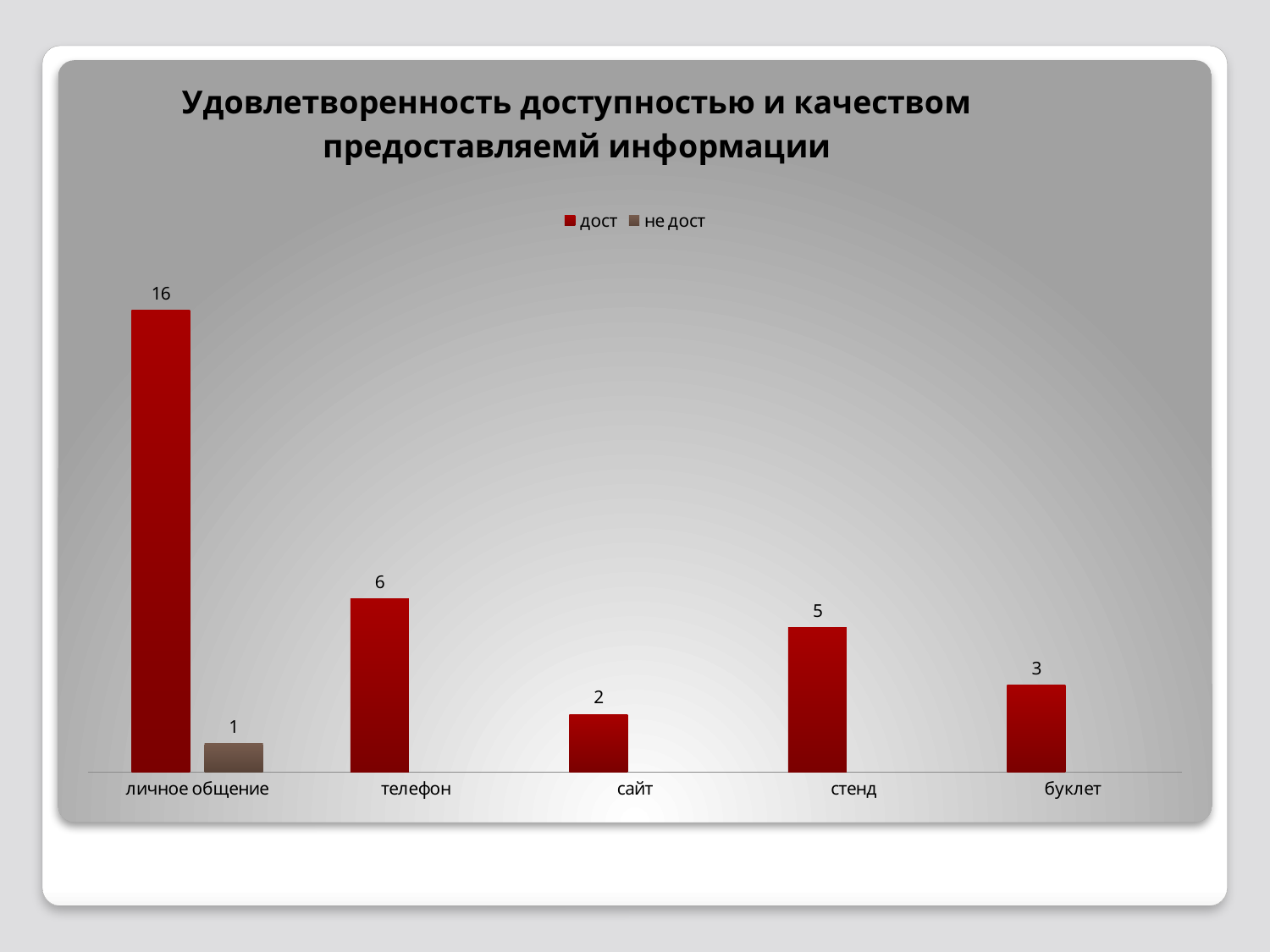
How many categories are shown on the x axis? 5 What is the value of "дост" for "телефон"? 6 What is the value of "дост" for "личное общение"? 16 What is the difference between the "дост" values for "личное общение" and "телефон"? 10 How many series does the legend list? 2 What is the title of the chart? Удовлетворенность доступностью и качеством предоставляемй информации What is the value of "не дост" for "личное общение"? 1 Which category has the lowest "дост" value? сайт Which category has the highest "дост" value? личное общение Which is larger, the "дост" value for "стенд" or for "буклет"? стенд What is the value of "дост" for "стенд"? 5 What kind of chart is shown on the slide? bar chart